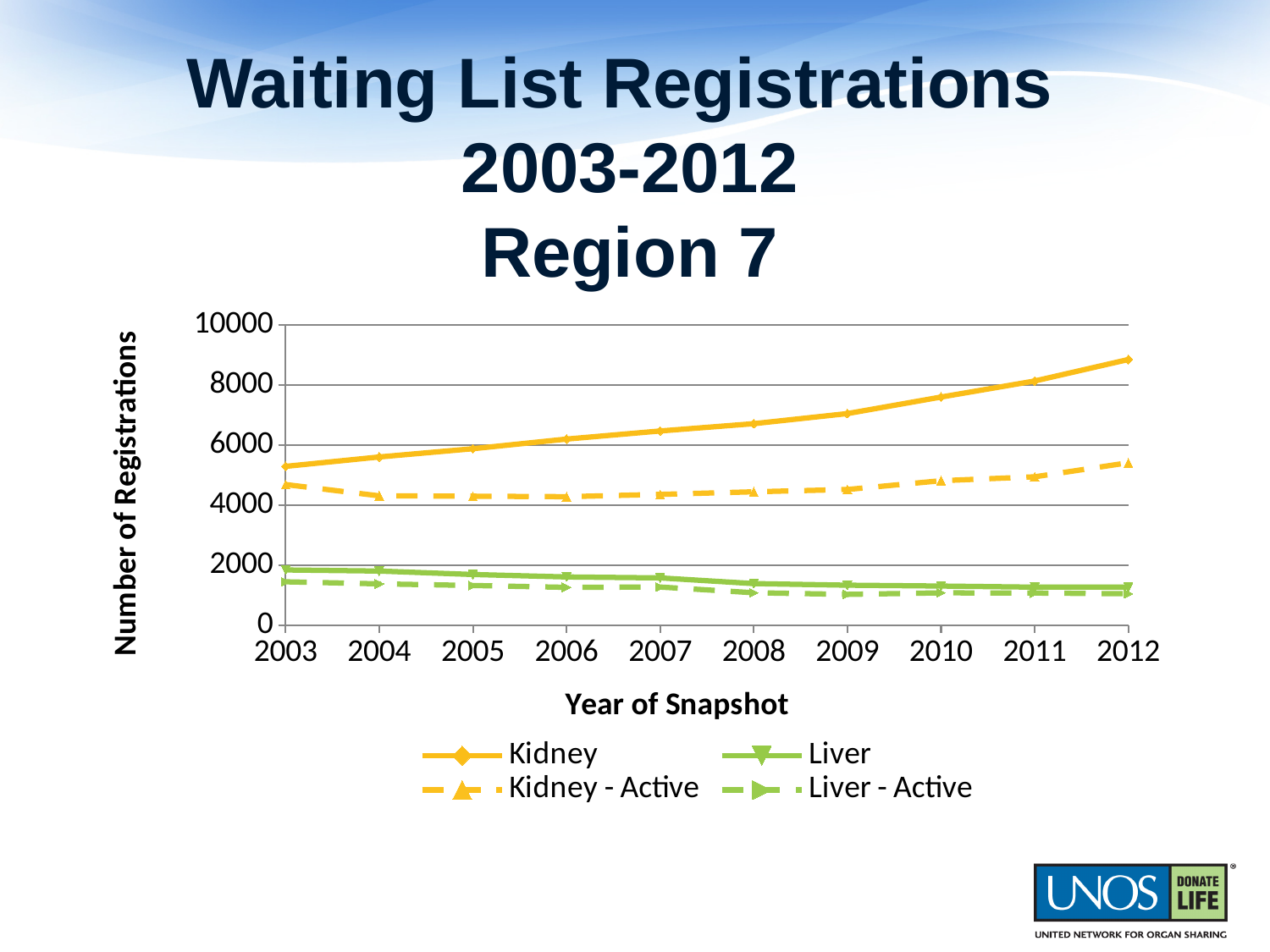
In which year is the Kidney series at its highest? 2012 How many series does the legend list? 4 Is the value for Kidney in 2003 greater or less than 6000? less Is the value for Kidney - Active in 2012 greater or less than 4000? greater What is the title of the x axis? Year of Snapshot Is the value for Kidney in 2012 greater or less than 8000? greater Does the Liver series rise or fall from 2003 to 2012? Falls How many years are plotted along the x axis? 10 Does the Kidney series rise or fall from 2003 to 2012? Rises Which series has the highest value in 2012? Kidney What kind of chart is shown on the slide? Line chart